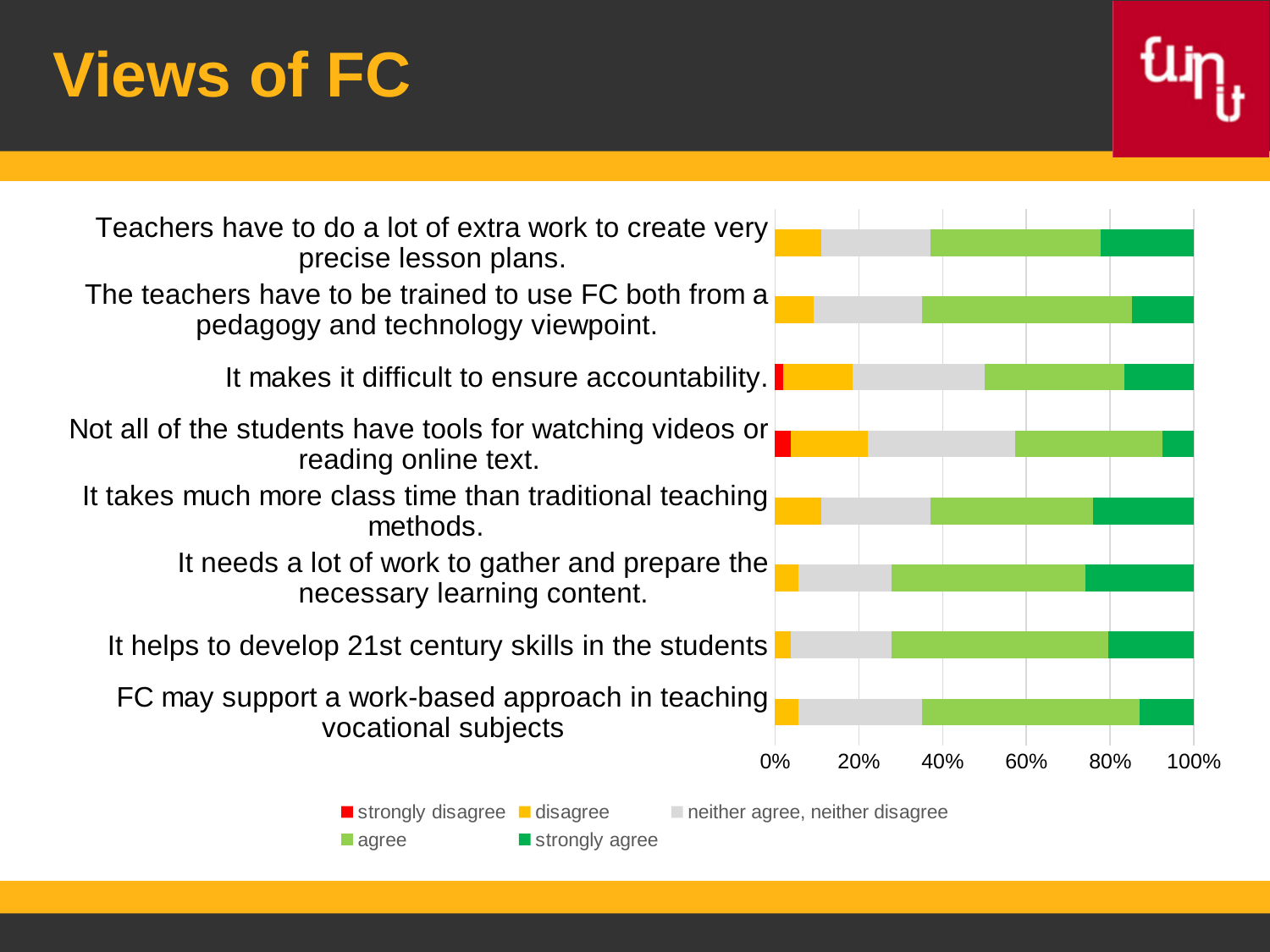
Is the 'agree' share for 'It needs a lot of work to gather and prepare the necessary learning content.' greater or less than 40%? greater What is the title of the slide containing the chart? Views of FC What is the highest value shown on the horizontal axis? 100% How many series does the legend list? 5 Is the 'disagree' share for 'It makes it difficult to ensure accountability.' greater or less than 20%? less Which has the larger 'strongly agree' share: 'Teachers have to do a lot of extra work to create very precise lesson plans.' or 'Not all of the students have tools for watching videos or reading online text.'? Teachers have to do a lot of extra work to create very precise lesson plans. What kind of chart is shown on the slide? stacked bar chart Which has the larger 'strongly agree' share: 'It helps to develop 21st century skills in the students' or 'FC may support a work-based approach in teaching vocational subjects'? It helps to develop 21st century skills in the students Which statement has the smallest 'strongly agree' share? Not all of the students have tools for watching videos or reading online text. How many statements (categories) are plotted in the chart? 8 Which legend entry is shown in red? strongly disagree Is the 'strongly agree' share for 'Not all of the students have tools for watching videos or reading online text.' greater or less than 20%? less